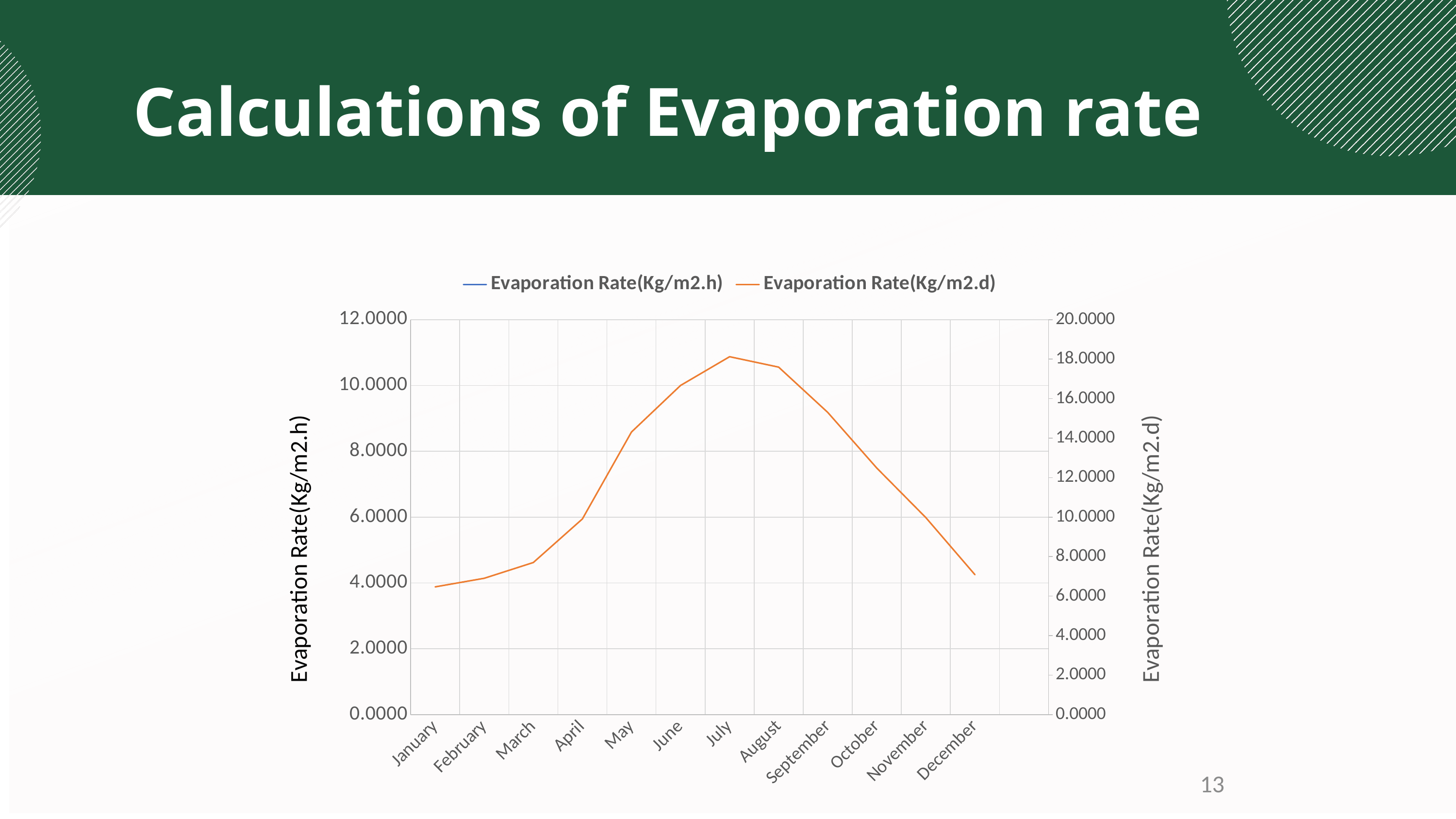
Is the Evaporation Rate(Kg/m2.d) value for July greater or less than 16.0000 on the right axis? greater Which month has the larger Evaporation Rate(Kg/m2.d) value, August or November? August In which month does the Evaporation Rate(Kg/m2.d) line reach its highest value? July What is the title of the slide containing the chart? Calculations of Evaporation rate What kind of chart is shown on the slide? line chart Is the Evaporation Rate(Kg/m2.d) value for May greater or less than 12.0000 on the right axis? greater Does the Evaporation Rate(Kg/m2.d) line rise or fall from July to December? fall Which month has the larger Evaporation Rate(Kg/m2.d) value, June or March? June How many series does the chart legend list? 2 In which month does the Evaporation Rate(Kg/m2.d) line reach its lowest value? January Is the Evaporation Rate(Kg/m2.d) value for January greater or less than 8.0000 on the right axis? less How many months are plotted along the x axis of the chart? 12